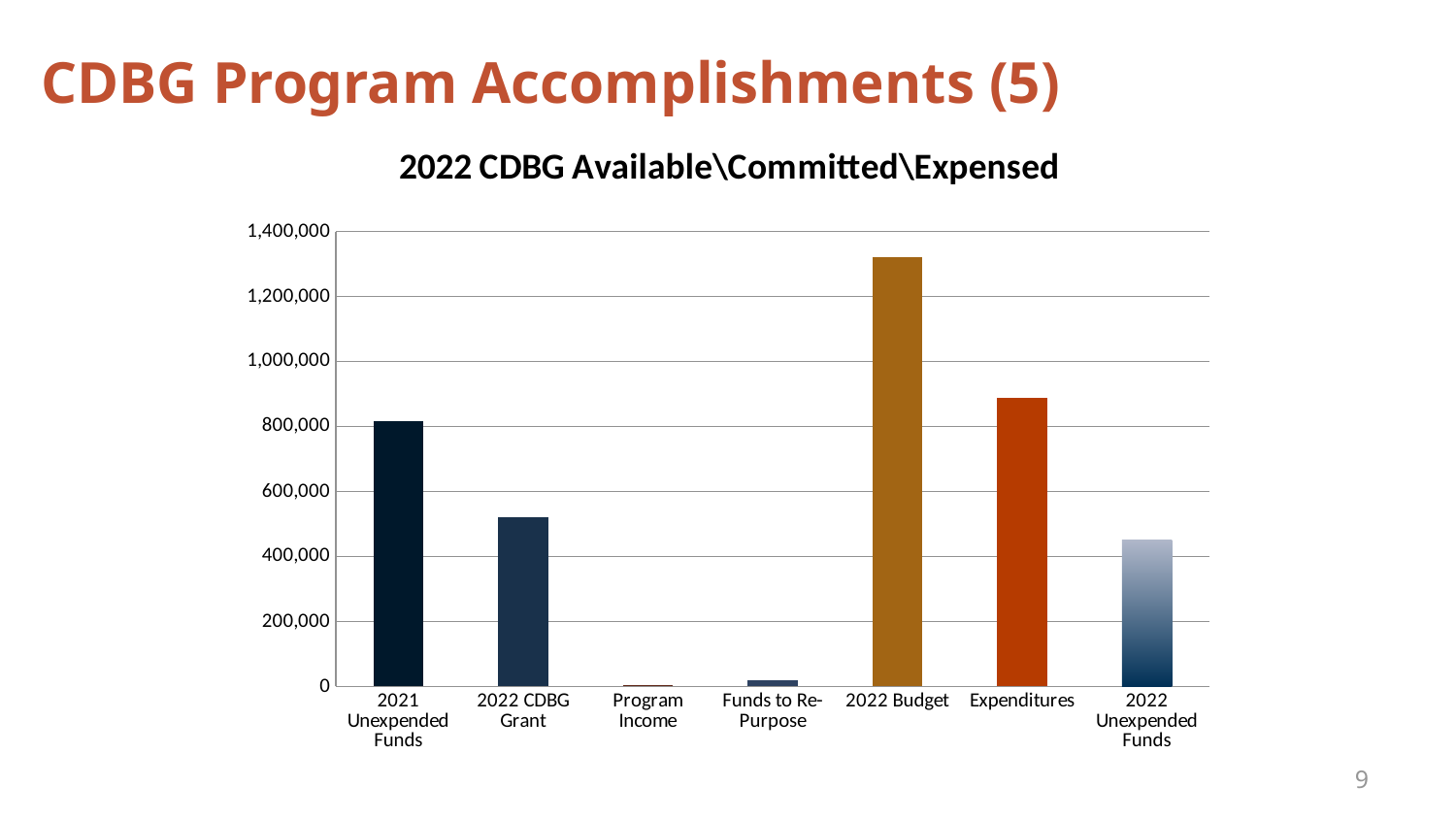
Which category has the lowest value in the chart? Program Income Is the value for 2022 CDBG Grant greater or less than 400,000? greater What is the title of the chart? 2022 CDBG Available\Committed\Expensed Is the value for 2022 Budget greater or less than 1,200,000? greater Which category has the highest value in the chart? 2022 Budget Which is larger, the value for 2022 CDBG Grant or the value for 2022 Unexpended Funds? 2022 CDBG Grant What type of chart is shown on the slide? Bar chart How many categories are shown on the x axis of the chart? 7 Is the value for Expenditures greater or less than 1,000,000? less Which is larger, the value for Expenditures or the value for 2021 Unexpended Funds? Expenditures